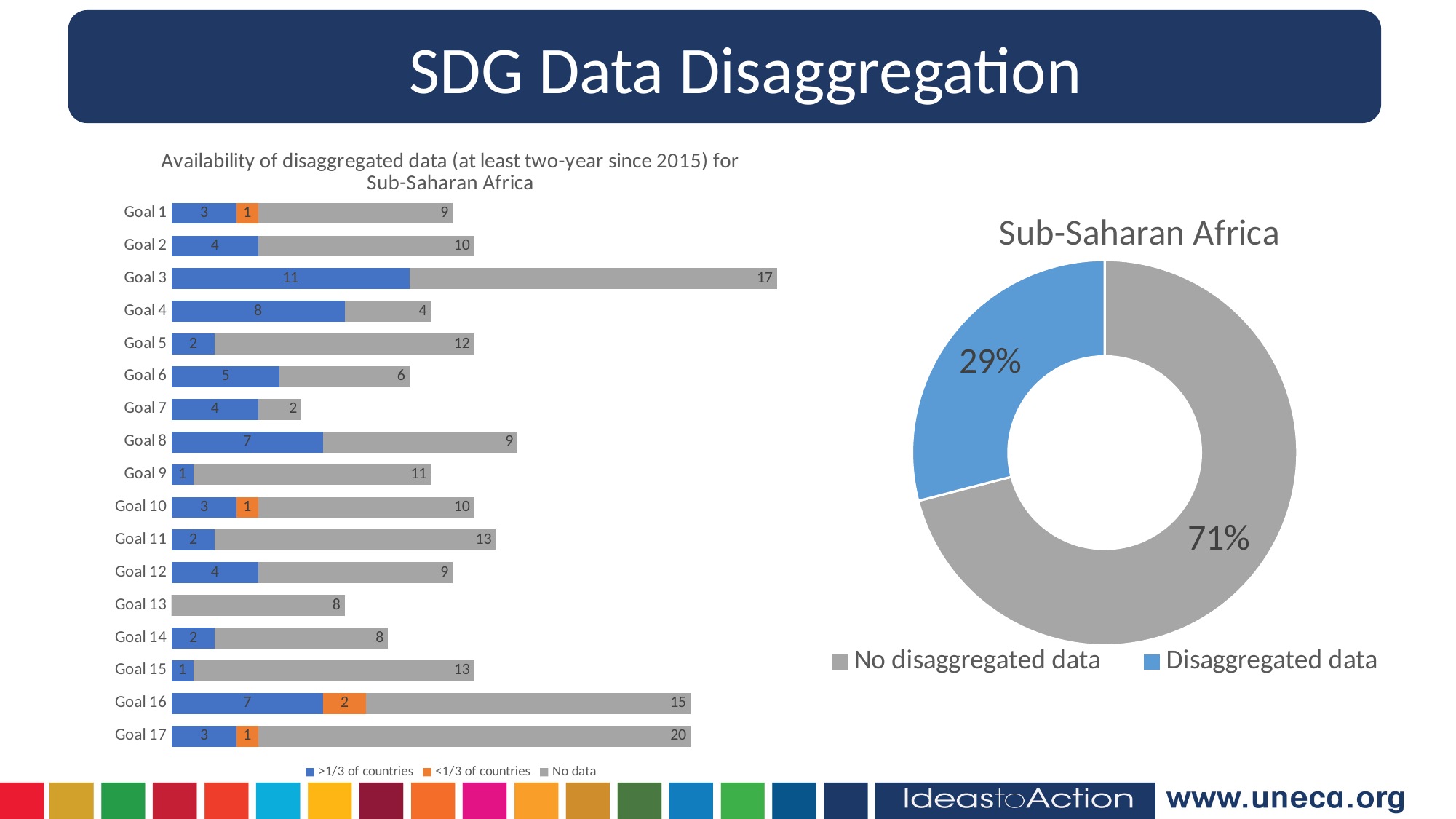
In the bar chart titled 'Availability of disaggregated data', what is the total of the stacked bar for Goal 16? 24 How many goals are shown in the bar chart titled 'Availability of disaggregated data'? 17 In the bar chart titled 'Availability of disaggregated data', which goal has the highest 'No data' value? Goal 17 In the bar chart titled 'Availability of disaggregated data', what is the 'No data' value for Goal 3? 17 What kind of chart is the chart on the right titled 'Sub-Saharan Africa'? Doughnut chart How many series does the legend of the bar chart titled 'Availability of disaggregated data' list? 3 In the bar chart titled 'Availability of disaggregated data', which goal has the highest '>1/3 of countries' value? Goal 3 In the doughnut chart titled 'Sub-Saharan Africa', what share is 'Disaggregated data'? 29% In the bar chart titled 'Availability of disaggregated data', which is larger: the '>1/3 of countries' value for Goal 8 or for Goal 6? Goal 8 In the bar chart titled 'Availability of disaggregated data', what is the '>1/3 of countries' value for Goal 4? 8 In the bar chart titled 'Availability of disaggregated data', what is the difference between the 'No data' values for Goal 17 and Goal 1? 11 In the bar chart titled 'Availability of disaggregated data', which goal has the lowest 'No data' value? Goal 7